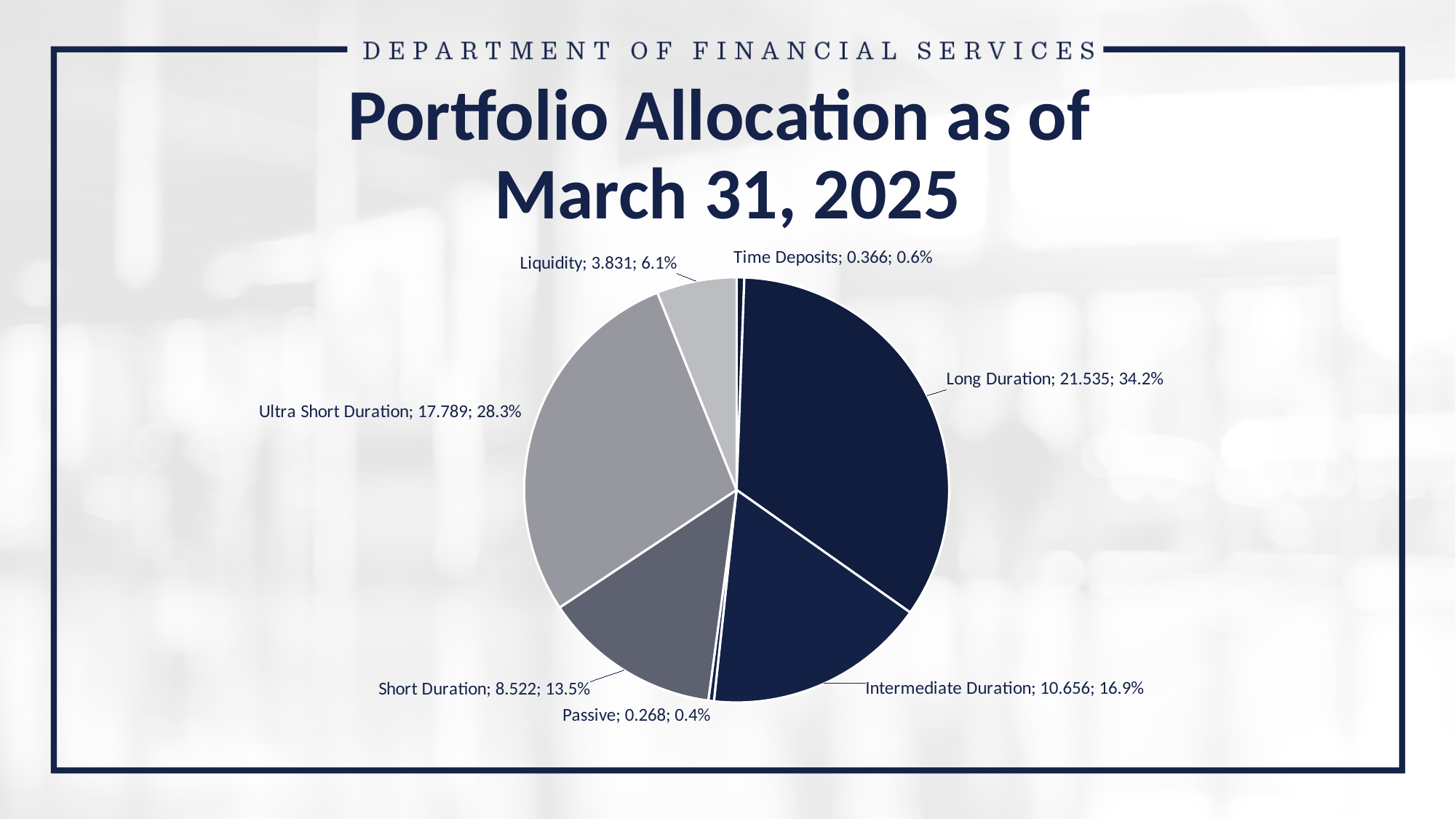
What percentage share does Ultra Short Duration have? 28.3% Which category has the largest share of the pie? Long Duration What is the title of the chart on the slide? Portfolio Allocation as of March 31, 2025 What is the difference in percentage share between Long Duration and Ultra Short Duration? 5.9% What value is shown for Intermediate Duration? 10.656 What percentage share does Liquidity have? 6.1% What type of chart is shown on the slide? Pie chart What value is shown for Time Deposits? 0.366 What value is shown for Long Duration? 21.535 Which is larger, Short Duration or Intermediate Duration? Intermediate Duration Which category has the smallest share of the pie? Passive How many slices does the pie chart have? 7